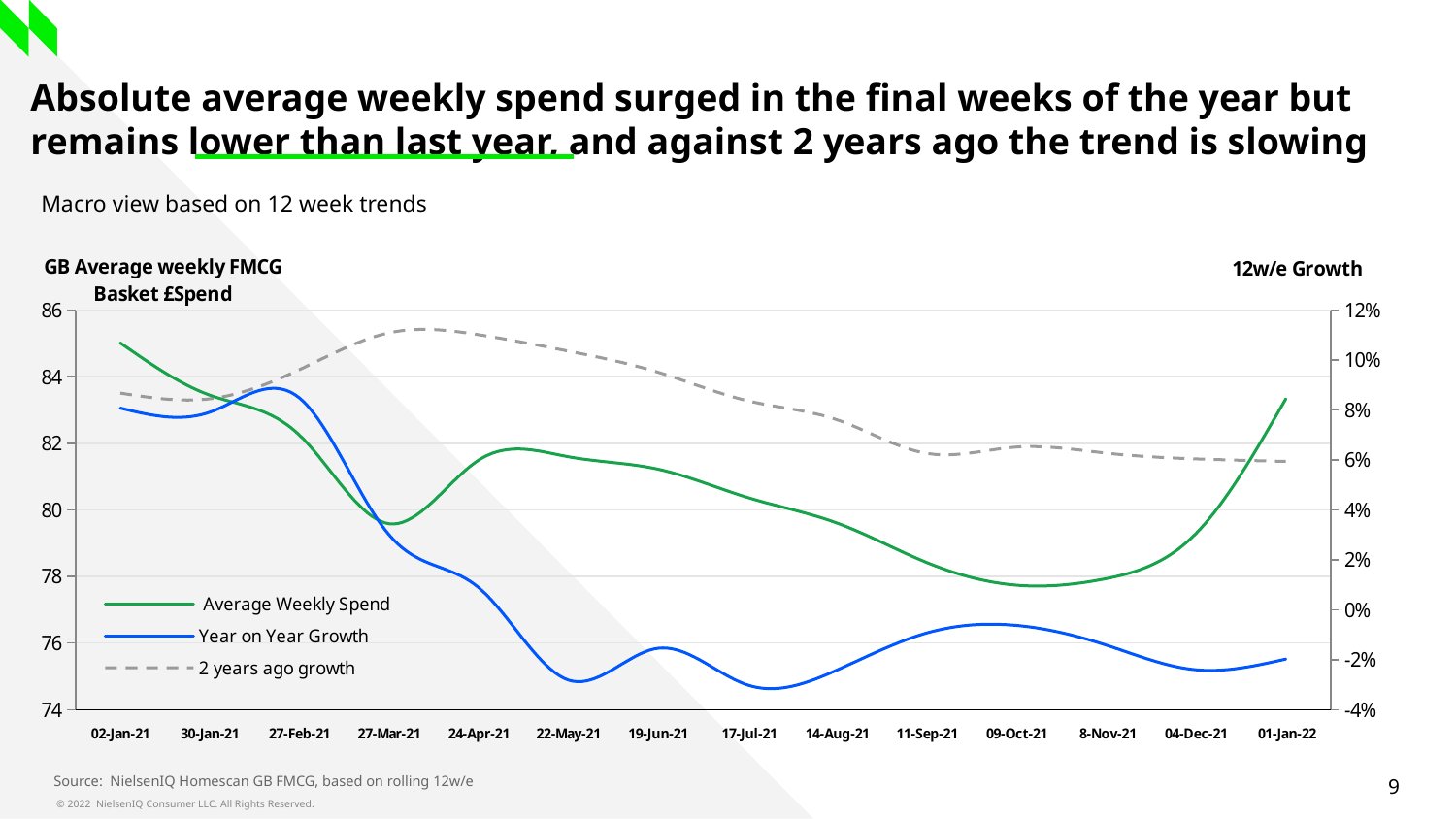
Is the 2 years ago growth at 27-Mar-21 greater or less than 10%? greater How many series does the chart legend list? 3 Is the Year on Year Growth at 01-Jan-22 greater or less than 0%? less How many dates are labelled along the x axis of the chart? 14 Which series is drawn as a dashed grey line? 2 years ago growth At which date is the Average Weekly Spend highest? 02-Jan-21 What is the title of the right-hand axis of the chart? 12w/e Growth What kind of chart is shown on the slide? Line chart Is the Average Weekly Spend at 09-Oct-21 greater or less than 78? less At 01-Jan-22, which is higher: Year on Year Growth or 2 years ago growth? 2 years ago growth Does the Year on Year Growth line rise or fall between 02-Jan-21 and 17-Jul-21? Fall